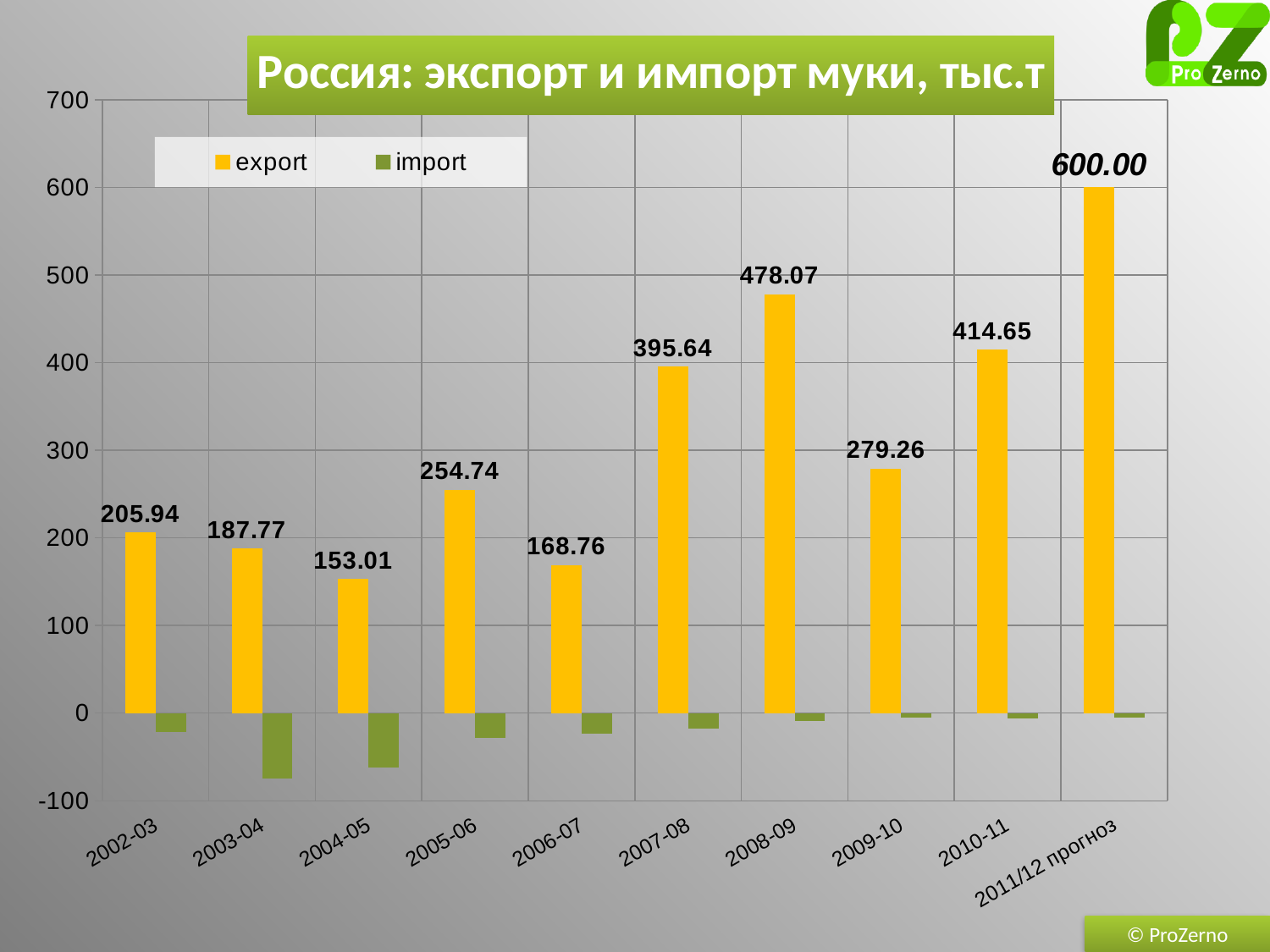
What is the export value for 2005-06? 254.74 Which category has the highest export value? 2011/12 прогноз What is the difference between the export values for 2008-09 and 2007-08? 82.43 Is the import value for 2003-04 greater or less than -50? less Which is larger, the export value for 2010-11 or for 2009-10? 2010-11 How many series does the legend list? 2 What is the export value for 2008-09? 478.07 Which category has the lowest export value? 2004-05 How many categories are shown on the x axis? 10 What is the forecast export value for 2011/12 прогноз? 600.00 Do the export values rise or fall from 2002-03 to 2004-05? fall What kind of chart is shown on the slide? bar chart